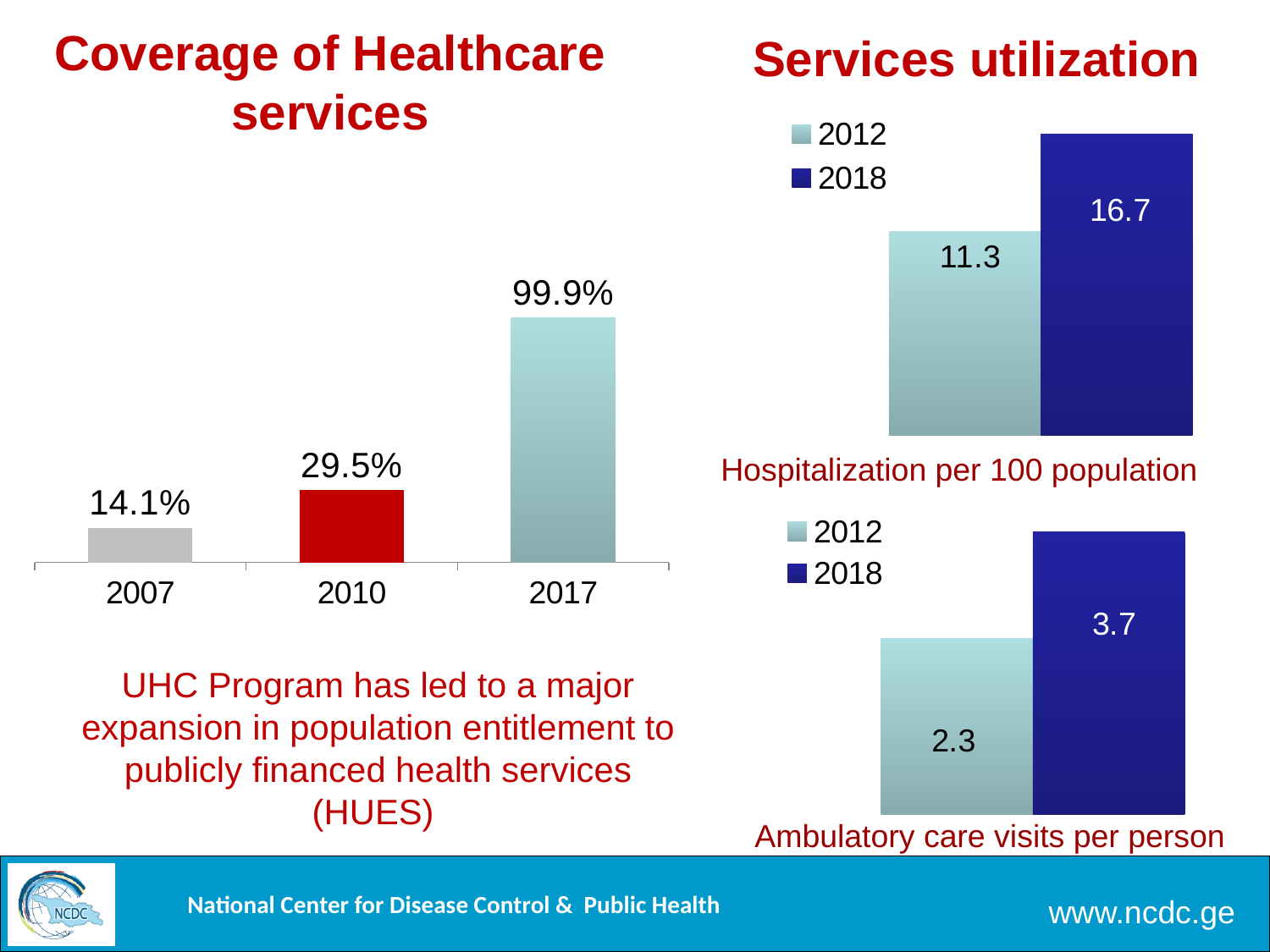
In the Ambulatory care visits per person chart, what is the value for 2012? 2.3 In the Coverage of Healthcare services chart, do the values rise or fall from 2007 to 2017? rise In the Ambulatory care visits per person chart, which year has the larger value, 2012 or 2018? 2018 In the Coverage of Healthcare services chart, which year has the lowest value? 2007 What kind of chart is the Ambulatory care visits per person chart? bar chart In the Coverage of Healthcare services chart, how many years are shown? 3 In the Hospitalization per 100 population chart, what is the value for 2018? 16.7 In the Hospitalization per 100 population chart, what is the difference between the 2018 and 2012 values? 5.4 In the Coverage of Healthcare services chart, what is the value for 2007? 14.1% In the Coverage of Healthcare services chart, what is the value for 2017? 99.9% How many series does the legend of the Hospitalization per 100 population chart list? 2 In the Coverage of Healthcare services chart, what is the difference between the 2010 and 2007 values? 15.4%